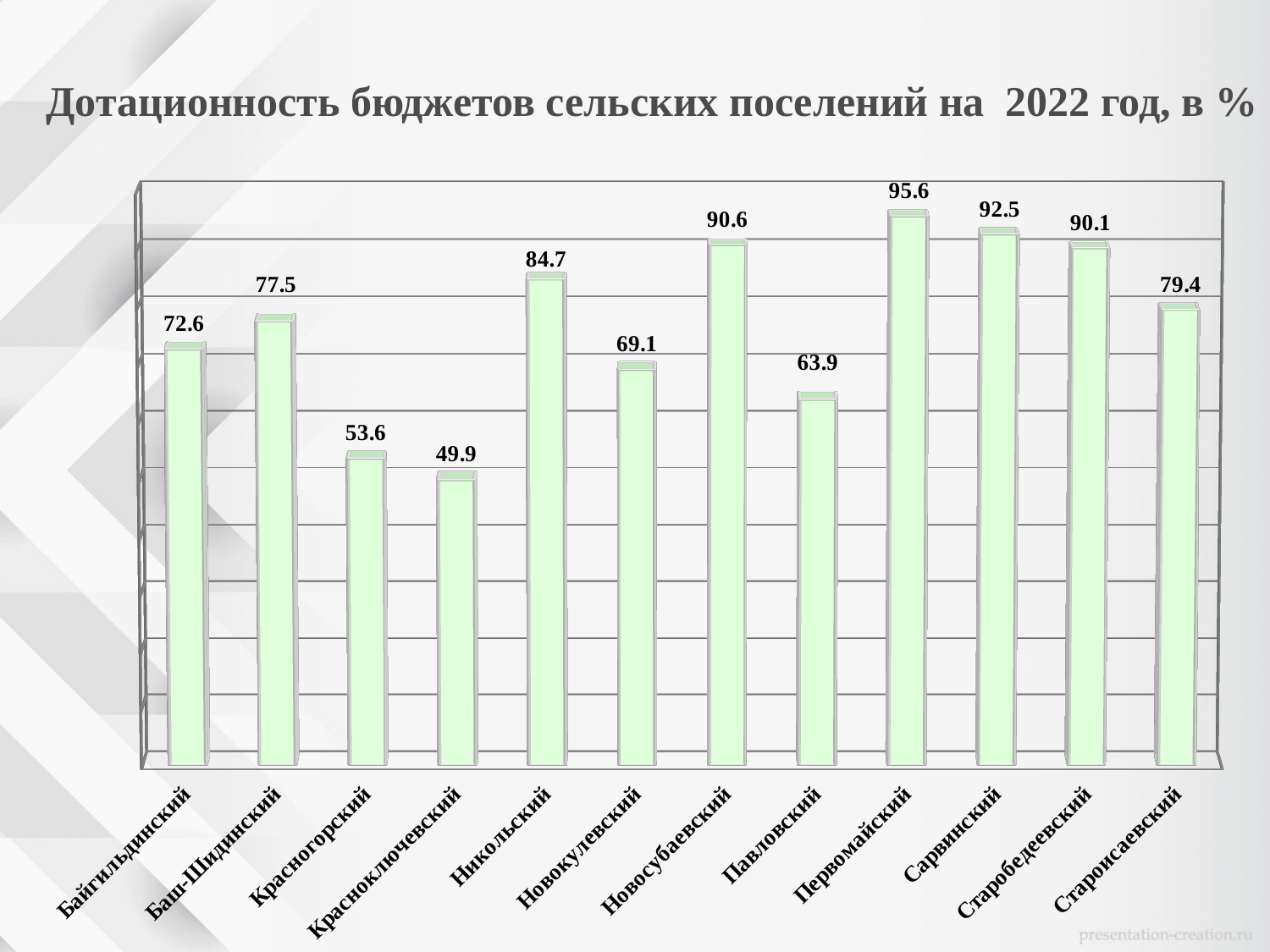
Which is larger, the value for Новосубаевский or the value for Сарвинский? Сарвинский Which settlement has the highest value? Первомайский What is the value for Никольский? 84.7 Which is larger, the value for Павловский or the value for Новокулевский? Новокулевский Which settlement has the lowest value? Красноключевский How many settlements are shown on the chart? 12 What is the difference between the values for Баш-Шидинский and Байгильдинский? 4.9 What kind of chart is shown on the slide? Bar chart What is the difference between the values for Первомайский and Красноключевский? 45.7 What is the value for Красноключевский? 49.9 What is the title of the chart? Дотационность бюджетов сельских поселений на 2022 год, в % What is the value for Старобедеевский? 90.1